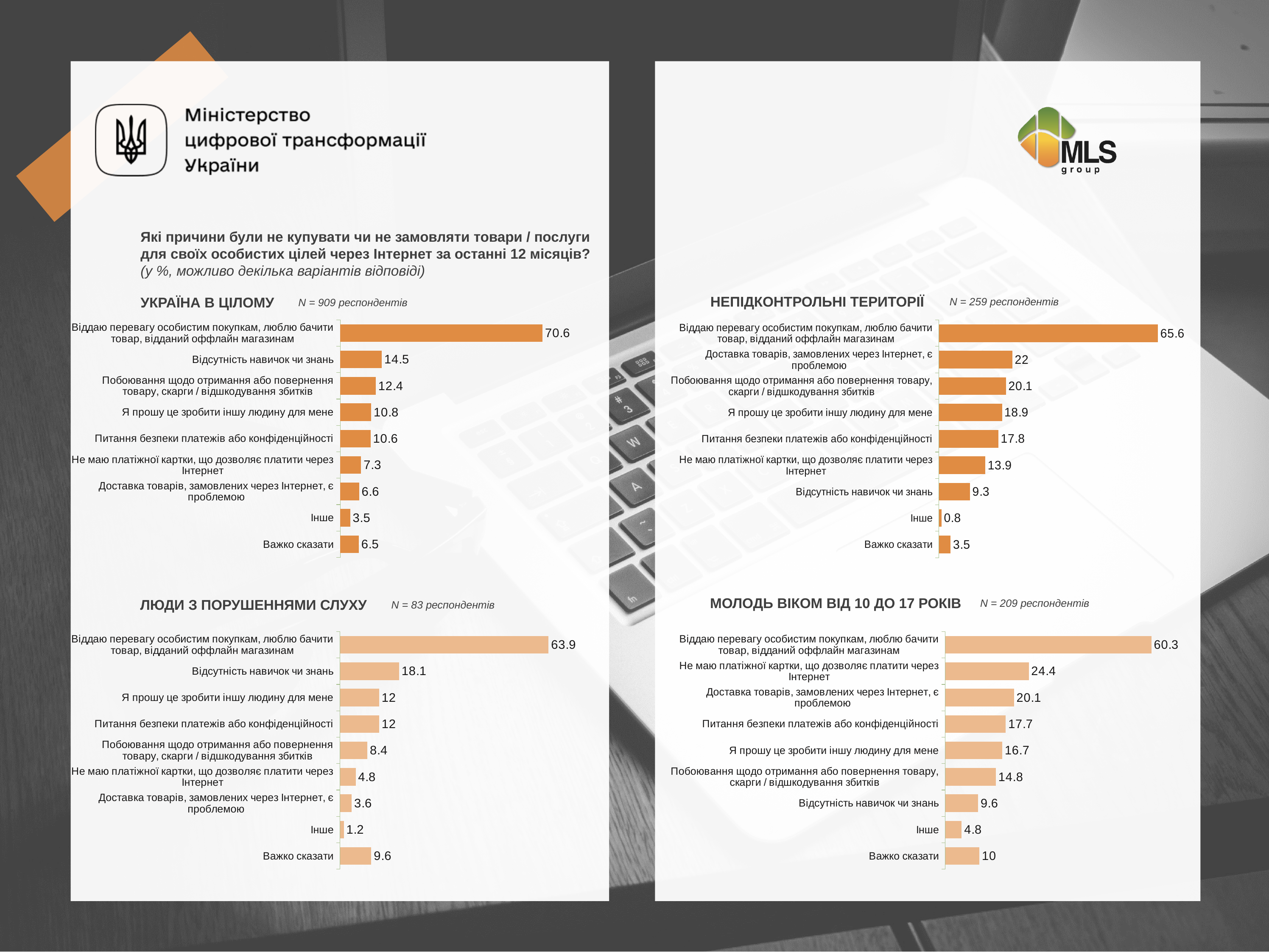
In the "МОЛОДЬ ВІКОМ ВІД 10 ДО 17 РОКІВ" chart, what is the value for "Не маю платіжної картки, що дозволяє платити через Інтернет"? 24.4 In the "УКРАЇНА В ЦІЛОМУ" chart, which category has the highest value? Віддаю перевагу особистим покупкам, люблю бачити товар, відданий оффлайн магазинам In the "УКРАЇНА В ЦІЛОМУ" chart, which category has the lowest value? Інше In the "ЛЮДИ З ПОРУШЕННЯМИ СЛУХУ" chart, how many categories are shown? 9 In the "НЕПІДКОНТРОЛЬНІ ТЕРИТОРІЇ" chart, what is the value for "Доставка товарів, замовлених через Інтернет, є проблемою"? 22 In the "УКРАЇНА В ЦІЛОМУ" chart, what is the value for "Відсутність навичок чи знань"? 14.5 In the "НЕПІДКОНТРОЛЬНІ ТЕРИТОРІЇ" chart, which category has the lowest value? Інше In the "МОЛОДЬ ВІКОМ ВІД 10 ДО 17 РОКІВ" chart, which is larger: "Питання безпеки платежів або конфіденційності" or "Я прошу це зробити іншу людину для мене"? Питання безпеки платежів або конфіденційності In the "ЛЮДИ З ПОРУШЕННЯМИ СЛУХУ" chart, what is the value for "Важко сказати"? 9.6 What kind of chart is the "МОЛОДЬ ВІКОМ ВІД 10 ДО 17 РОКІВ" chart? Bar chart How many respondents (N) are indicated for the "ЛЮДИ З ПОРУШЕННЯМИ СЛУХУ" chart? 83 In the "НЕПІДКОНТРОЛЬНІ ТЕРИТОРІЇ" chart, what is the difference between "Віддаю перевагу особистим покупкам, люблю бачити товар, відданий оффлайн магазинам" and "Доставка товарів, замовлених через Інтернет, є проблемою"? 43.6